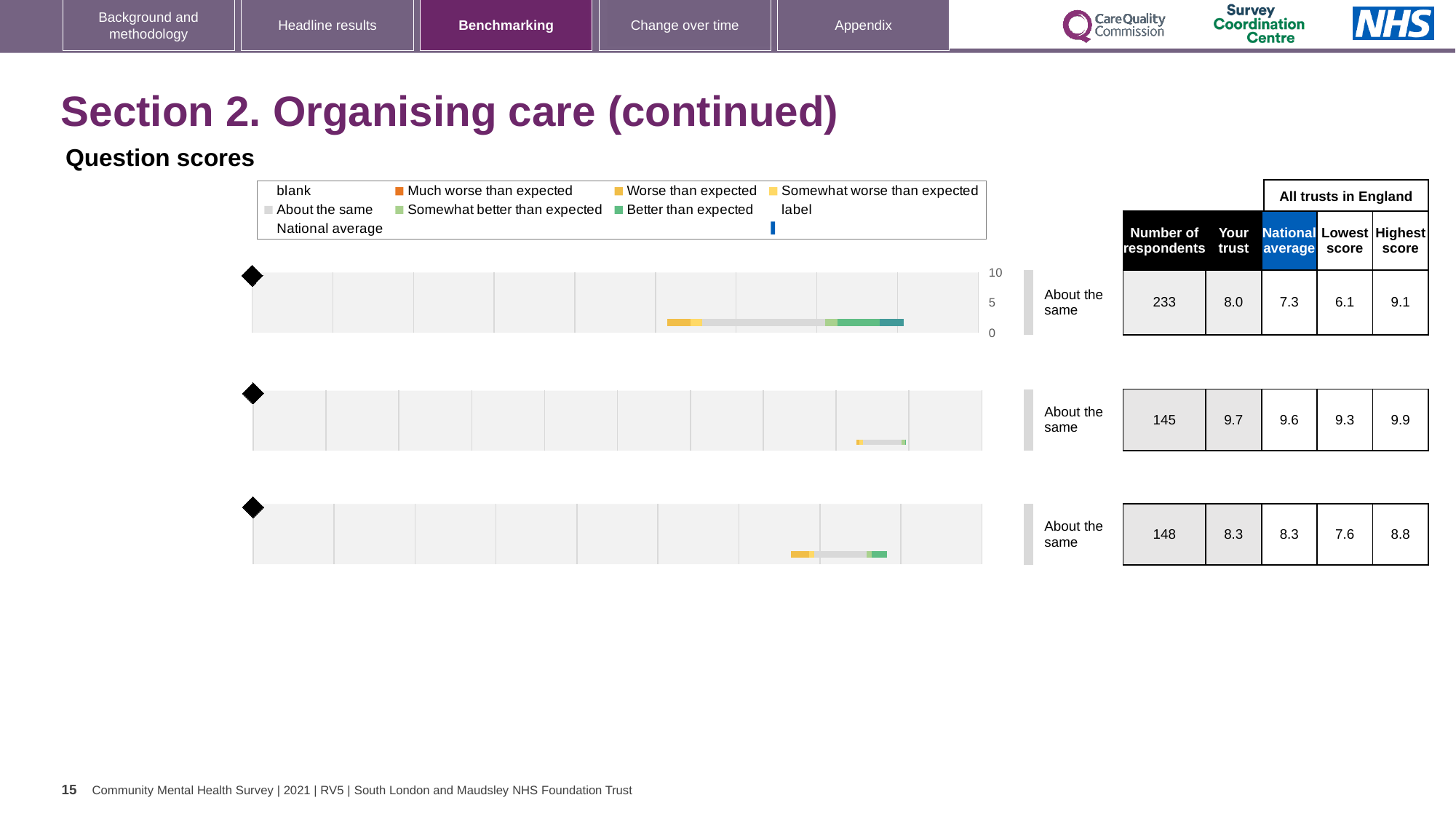
For the top chart row, what is the difference between the 'Your trust' score and the national average? 0.7 Which chart row (top, middle or bottom) has the highest 'Your trust' score? middle Which chart row (top, middle or bottom) has the lowest 'Lowest score' value? top What benchmark category label is shown next to each of the three chart rows? About the same How many benchmarking charts (question rows) are shown on the slide? 3 For the bottom chart row, what is the difference between the highest score and the lowest score? 1.2 For the bottom chart row, what is the national average shown in the table? 8.3 For the middle chart row, what is the highest score among all trusts in England? 9.9 For the top chart row, what is the number of respondents shown in the table? 233 For the top chart row, which is larger: the 'Your trust' score or the national average? Your trust For the middle chart row, what is the 'Your trust' score shown in the table? 9.7 What kind of chart is the top chart on the slide? bar chart